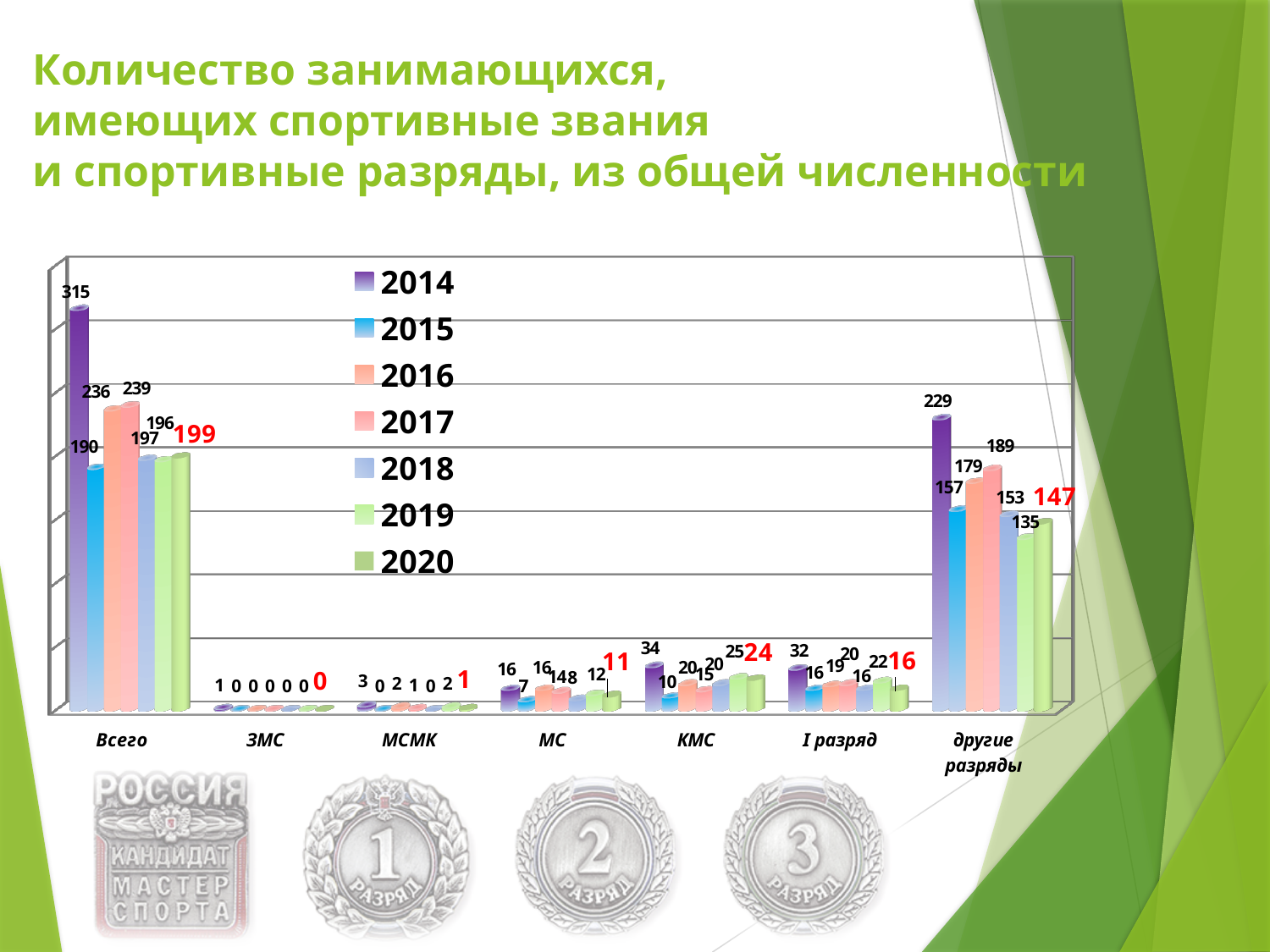
Which is larger in the МС category: the value for 2014 or the value for 2015? 2014 What is the value for 2019 in the I разряд category? 22 What is the value for 2017 in the КМС category? 15 How many series does the legend list? 7 Which year has the lowest value in the Всего category? 2015 How many categories are shown on the x axis? 7 What kind of chart is shown on the slide? bar chart Which year has the highest value in the другие разряды category? 2014 What is the value for 2020 in the другие разряды category? 147 What is the value for 2014 in the Всего category? 315 What is the value for 2015 in the ЗМС category? 0 What is the difference between the 2014 and 2020 values in the Всего category? 116